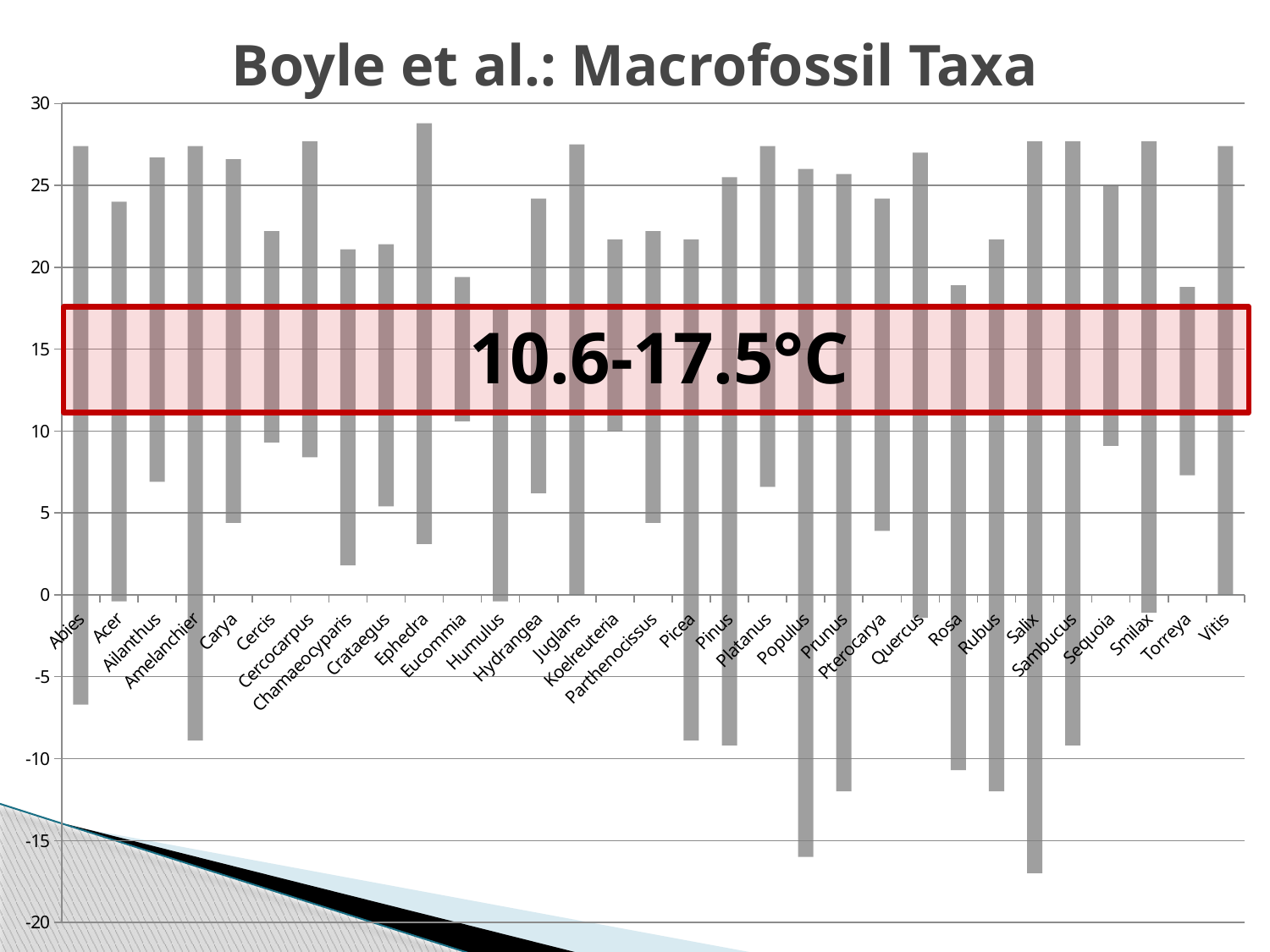
Is the top of the bar for Ephedra greater or less than 25? greater Is the top of the bar for Cercis greater or less than 25? less Is the top of the bar for Torreya greater or less than 20? less Which bar reaches higher, Ephedra or Acer? Ephedra How many taxa (categories) are plotted along the x axis? 31 What is the title of the chart? Boyle et al.: Macrofossil Taxa What temperature range is written in the highlighted red box on the chart? 10.6-17.5°C What kind of chart is shown on the slide? bar chart Which taxon's bar reaches the highest value on the chart? Ephedra